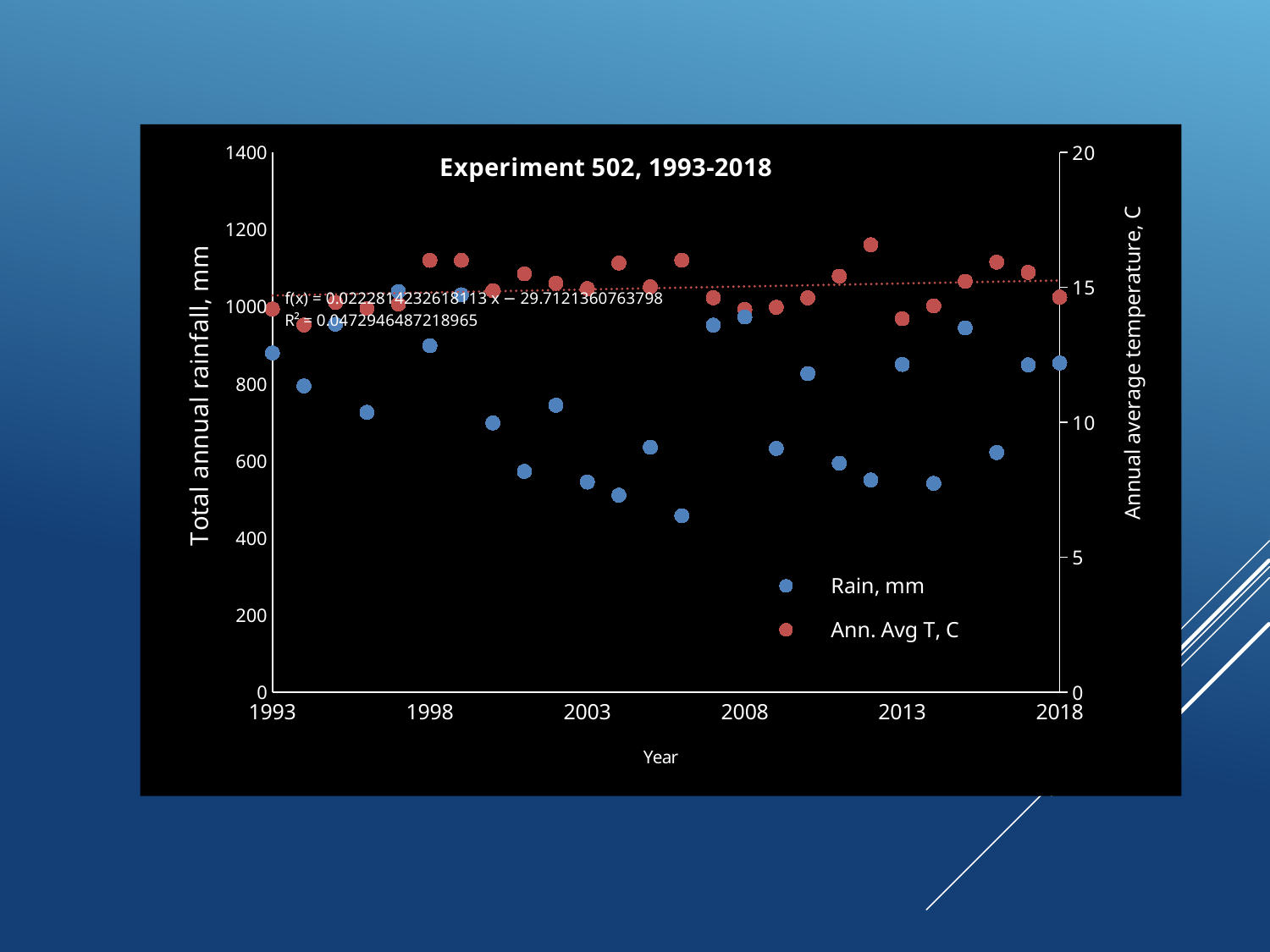
In which year is the Rain, mm value lowest? 2006 How many series does the legend list? 2 Is the Rain, mm value for 1993 greater or less than 800? greater Is the Ann. Avg T, C value for 1994 greater or less than 15? less Does the dotted trendline for Ann. Avg T, C rise or fall from 1993 to 2018? rises What is the title of the chart? Experiment 502, 1993-2018 Which year has the larger Rain, mm value, 1993 or 2006? 1993 What are the two series named in the legend? Rain, mm and Ann. Avg T, C In which year is the Ann. Avg T, C value highest? 2012 Is the Ann. Avg T, C value for 2012 greater or less than 15? greater What kind of chart is shown on the slide? Scatter chart